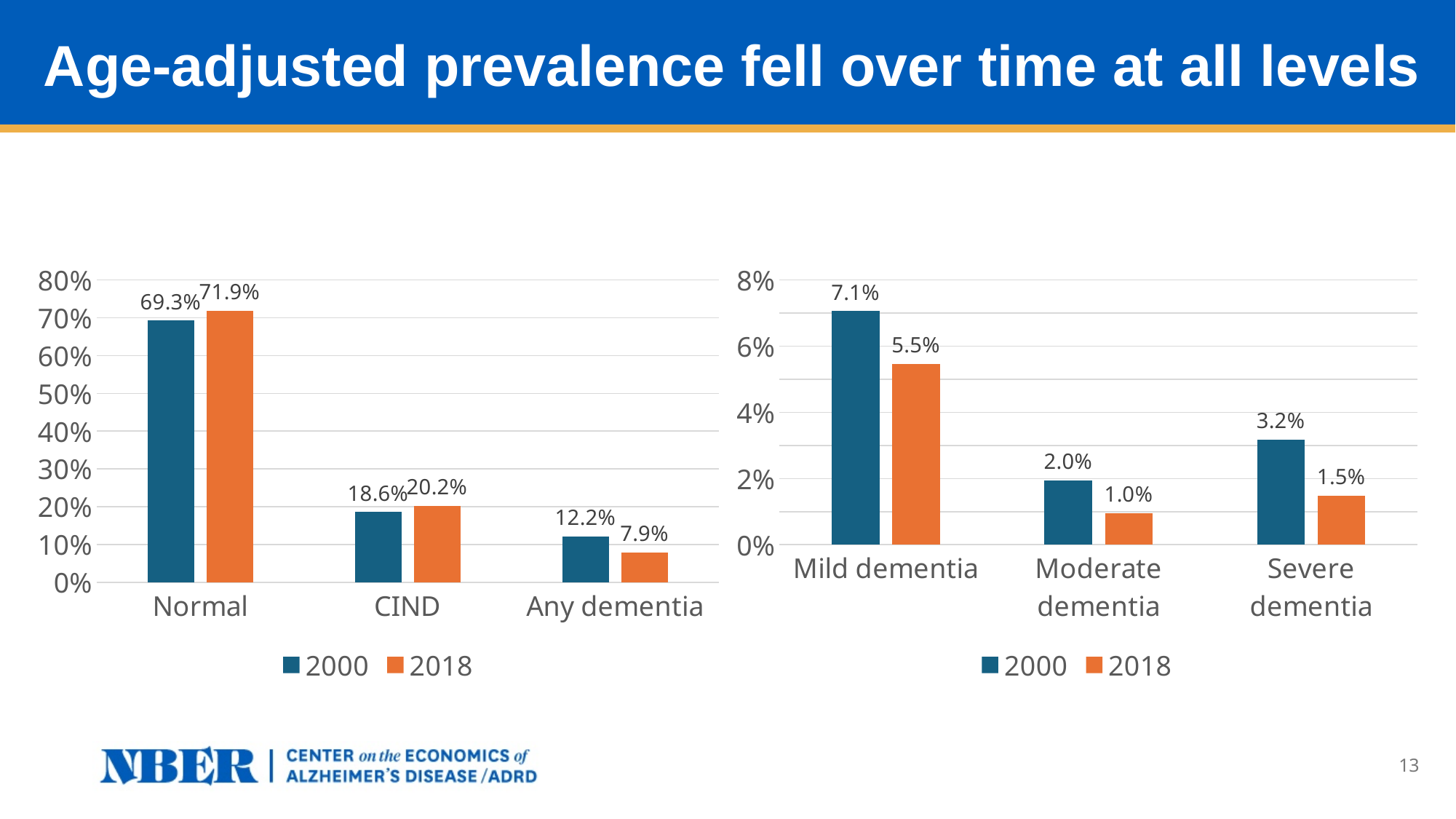
In the right chart, what is the 2000 value for Severe dementia? 3.2% In the left chart, which category has the lowest 2018 value? Any dementia How many series does the legend of the left chart list? 2 In the right chart, which category has the highest 2000 value? Mild dementia In the right chart, what is the 2018 value for Moderate dementia? 1.0% In the left chart, what is the 2018 value for Any dementia? 7.9% In the right chart, what is the difference between the 2000 and 2018 values for Severe dementia? 1.7% How many categories are shown on the x axis of the right chart? 3 In the left chart, which is larger for CIND: the 2000 value or the 2018 value? 2018 What kind of chart is the right chart? Bar chart In the left chart, what is the 2000 value for Normal? 69.3% In the right chart, what is the difference between the 2000 and 2018 values for Mild dementia? 1.6%